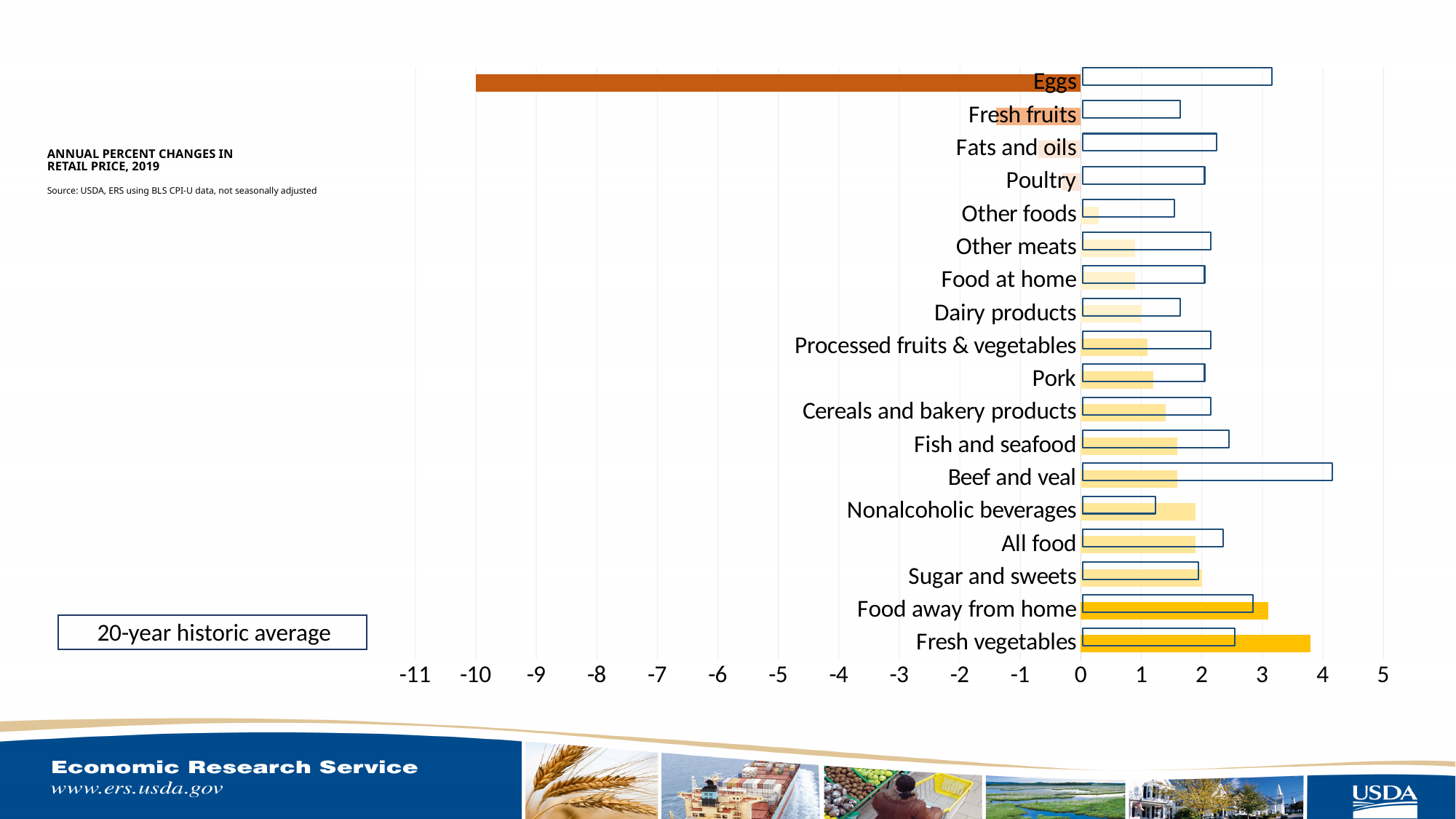
Is the 2019 value for Eggs greater or less than -5? less Which category has the highest 20-year historic average? Beef and veal How many food categories are plotted in the chart? 18 Is the 2019 value for Other foods greater or less than 1? less What kind of chart is shown on the slide? bar chart Is the 2019 value for Beef and veal greater or less than 2? less What do the outlined (hollow) bars in the chart represent? 20-year historic average Which has the larger 2019 value, Fresh vegetables or Food away from home? Fresh vegetables Which category has the lowest annual percent change in retail price for 2019? Eggs Which category has the highest annual percent change in retail price for 2019? Fresh vegetables For Beef and veal, which is larger: the 2019 value or the 20-year historic average? the 20-year historic average